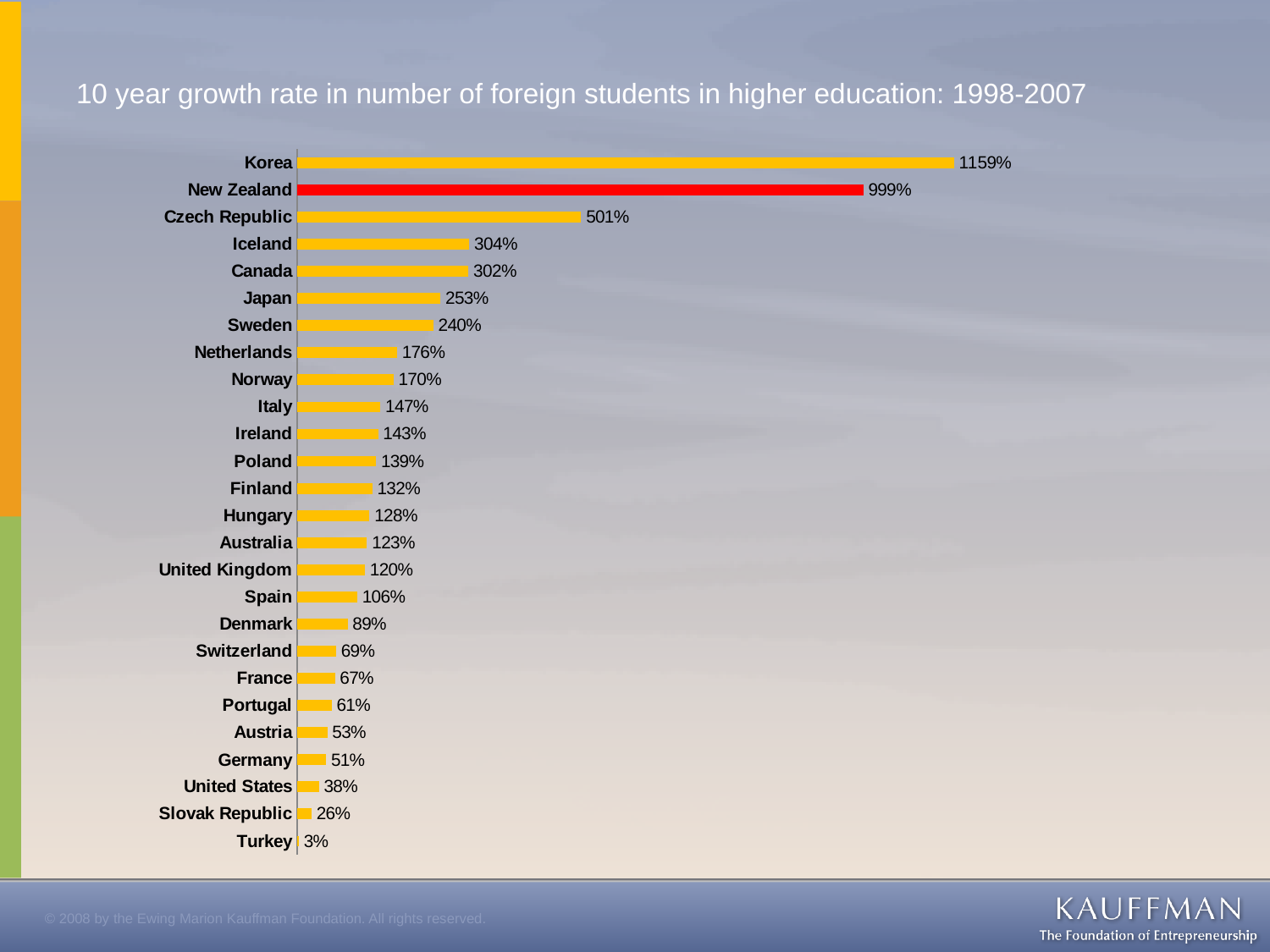
How many countries are shown in the chart? 26 What is the difference between the growth rates of Korea and New Zealand? 160% What is the growth rate shown for New Zealand? 999% What is the growth rate shown for the United States? 38% Which country's bar is highlighted in red? New Zealand Which has a higher growth rate, Japan or Sweden? Japan What kind of chart is shown on the slide? Bar chart What is the difference between the growth rates of Czech Republic and Iceland? 197% Which has a higher growth rate, Germany or Austria? Austria Which country has the lowest growth rate in number of foreign students? Turkey What is the 10 year growth rate in number of foreign students for Korea? 1159% Which country has the highest growth rate in number of foreign students? Korea